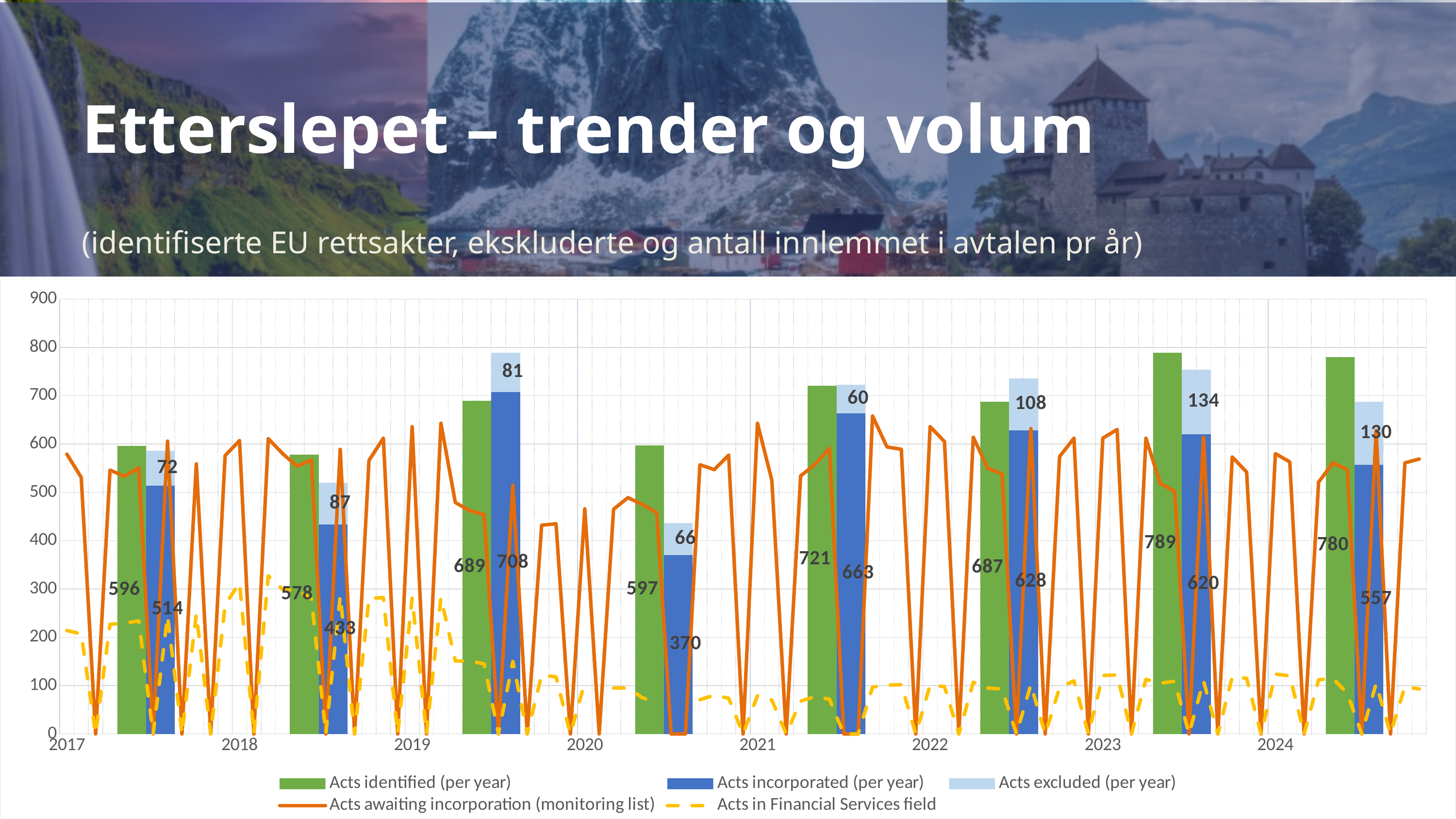
What is the value of Acts incorporated (per year) for 2020? 370 What is the value of Acts identified (per year) for 2023? 789 What is the total of Acts incorporated and Acts excluded stacked together for 2021? 723 Which year has the highest value for Acts identified (per year)? 2023 How many years are shown on the x axis? 8 What is the difference between Acts identified and Acts incorporated in 2024? 223 Which series is drawn as a dashed yellow line? Acts in Financial Services field How many series does the legend list? 5 What is the value of Acts excluded (per year) for 2022? 108 What kind of chart is shown on the slide? Combined bar and line chart Which year has the lowest value for Acts incorporated (per year)? 2020 Which is larger in 2019: Acts identified (per year) or Acts incorporated (per year)? Acts incorporated (per year)